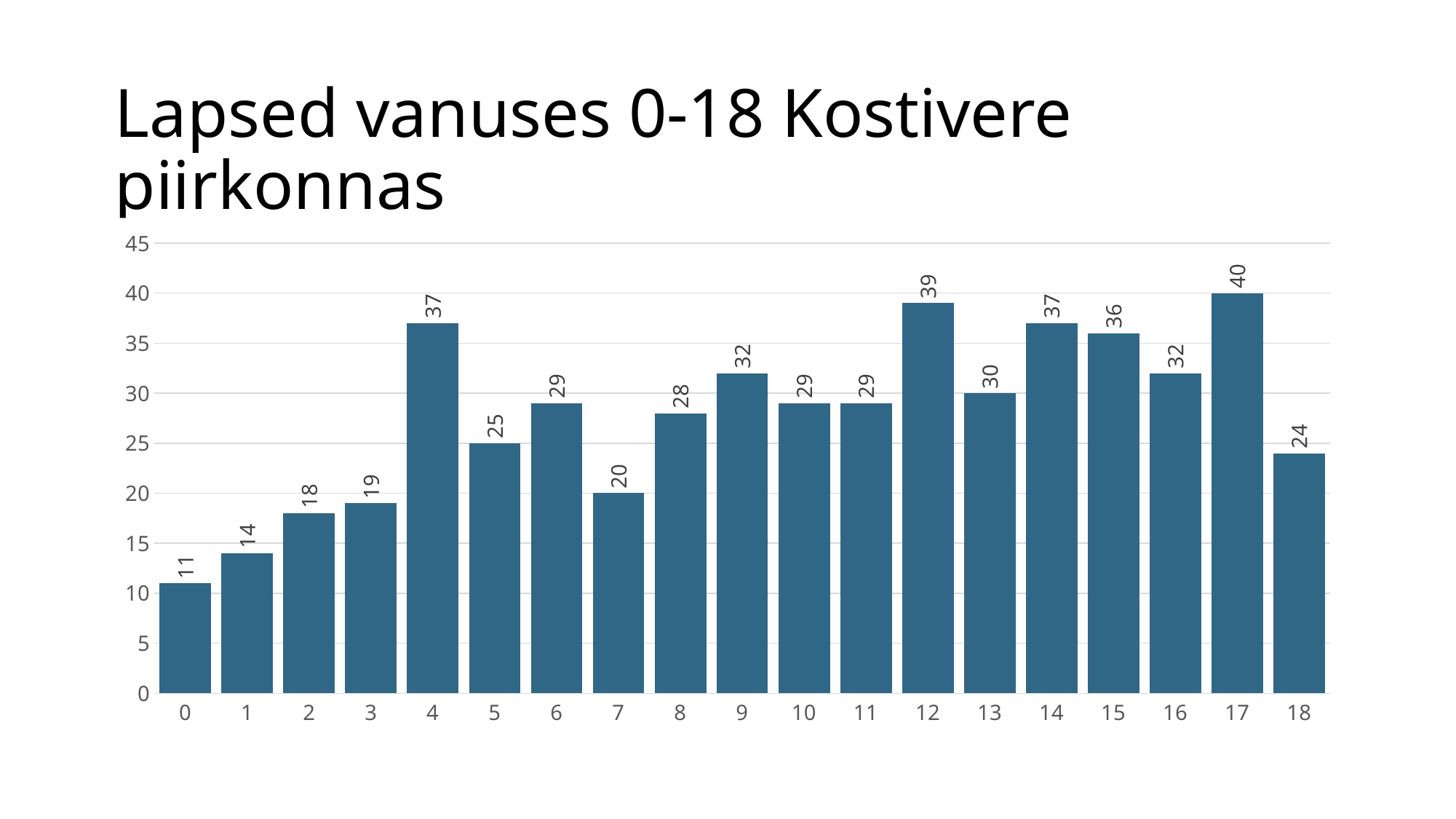
What is the value for age 18? 24 What is the difference between the values for age 17 and age 0? 29 What is the title of the chart? Lapsed vanuses 0-18 Kostivere piirkonnas Which age has the highest value? 17 What is the value for age 12? 39 What is the value for age 4? 37 Is the value for age 9 greater or less than 30? greater What is the difference between the values for age 4 and age 5? 12 How many age categories are shown on the x axis? 19 Which age has the lowest value? 0 Which is larger, the value for age 7 or the value for age 8? age 8 What kind of chart is shown on the slide? bar chart